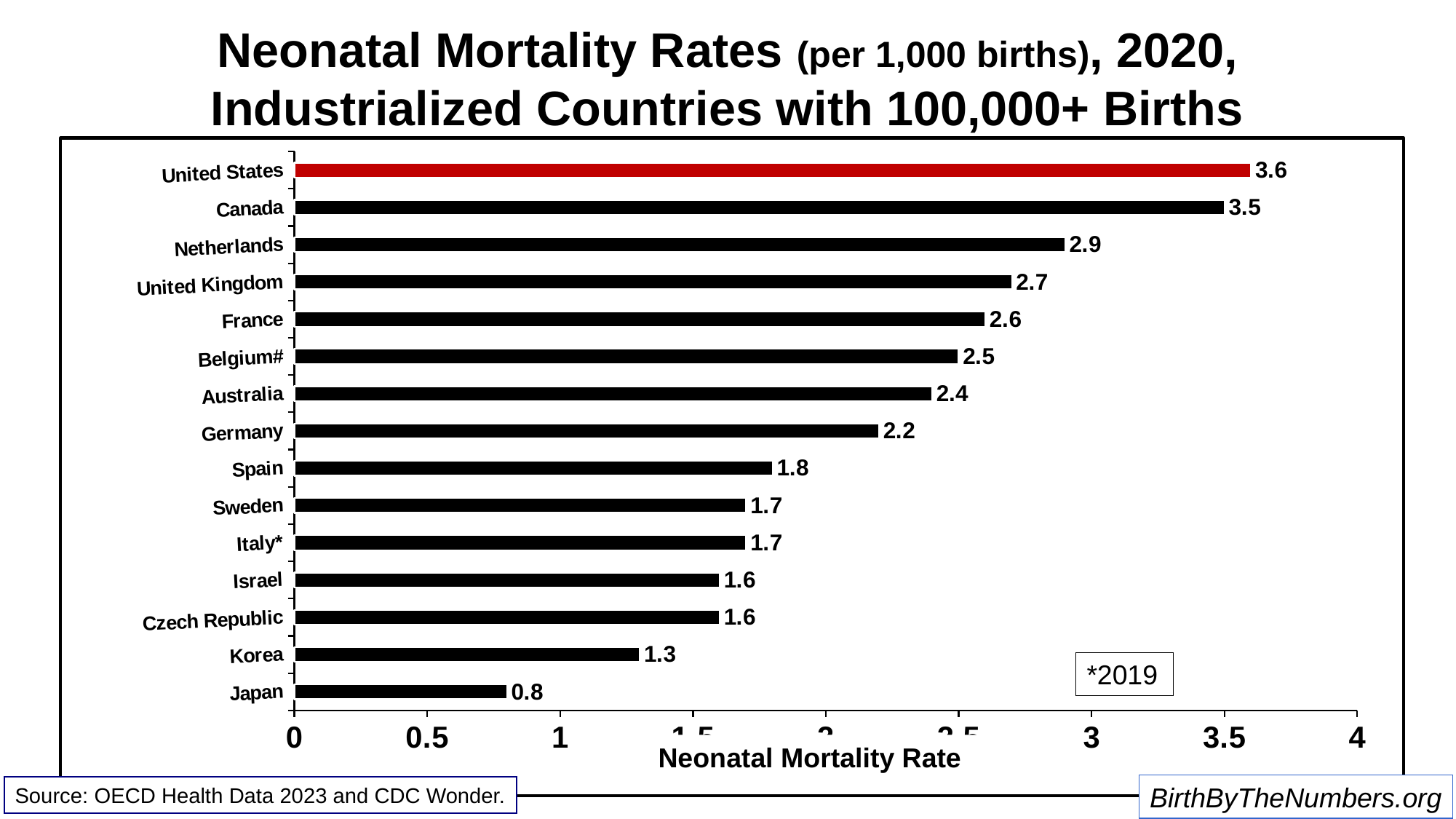
Which country has the highest neonatal mortality rate? United States What is the neonatal mortality rate for Korea? 1.3 How many countries are shown in the chart? 15 What type of chart is shown on the slide? Bar chart Is the value for Spain greater or less than 2? less What is the difference between the neonatal mortality rates of Canada and the Netherlands? 0.6 What is the neonatal mortality rate for the United States? 3.6 Which has a higher neonatal mortality rate, France or Australia? France Which country's bar is coloured red? United States Which country has the lowest neonatal mortality rate? Japan What is the neonatal mortality rate for Germany? 2.2 What is the difference between the neonatal mortality rates of the United States and Japan? 2.8